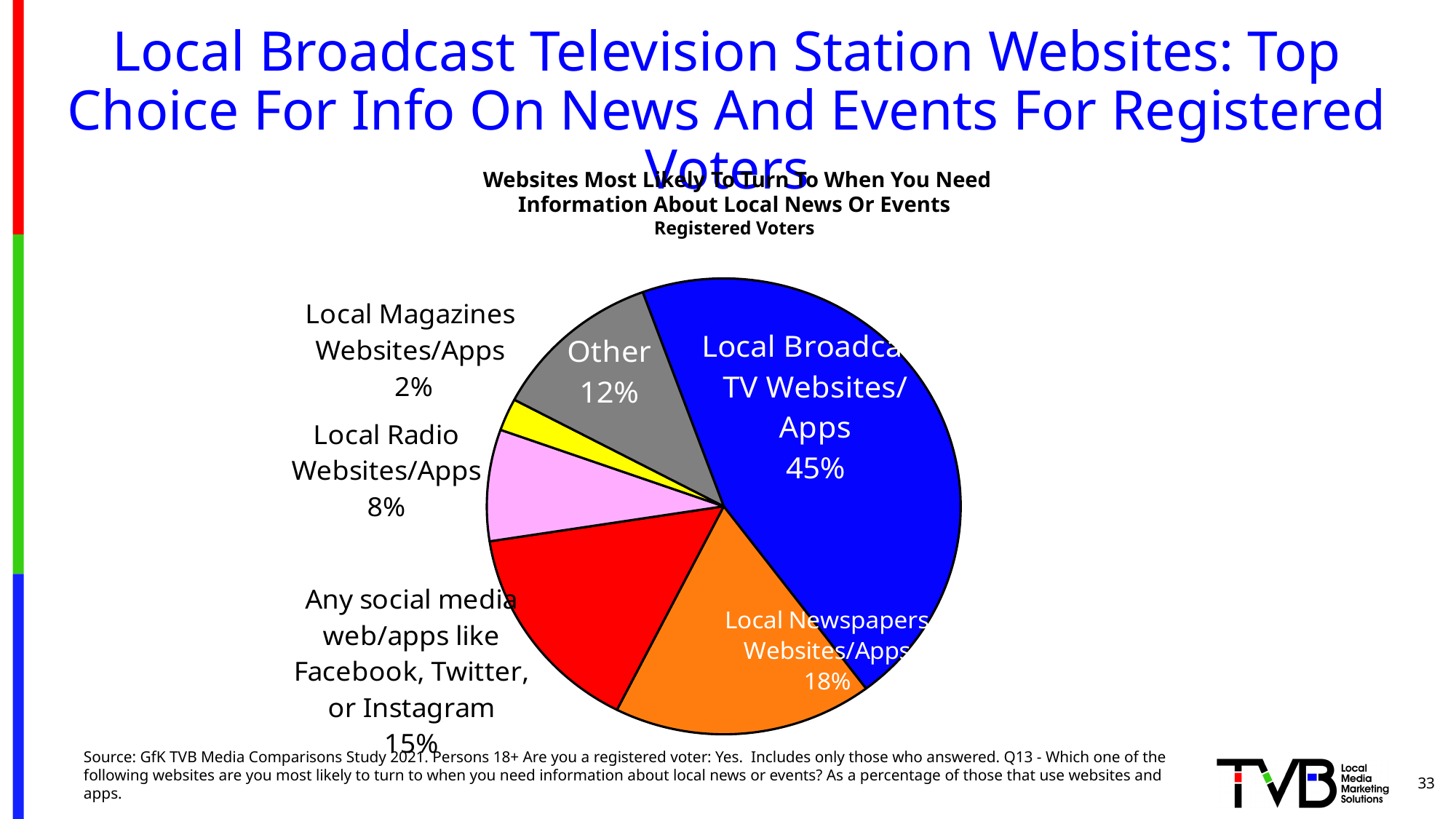
What share of registered voters chose Local Newspapers Websites/Apps? 18% What share of registered voters chose Local Broadcast TV Websites/Apps? 45% What kind of chart is shown on the slide? pie chart Which category has the smallest share of the pie? Local Magazines Websites/Apps Which is larger: the share for Local Radio Websites/Apps or the share for Other? Other What share of registered voters chose Local Radio Websites/Apps? 8% What share of registered voters chose any social media web/apps like Facebook, Twitter, or Instagram? 15% Which category has the largest share of the pie? Local Broadcast TV Websites/Apps What share of registered voters chose Local Magazines Websites/Apps? 2% How many percentage points larger is the Local Broadcast TV Websites/Apps share than the Local Newspapers Websites/Apps share? 27 percentage points What share is labelled Other? 12% How many slices does the pie chart have? 6